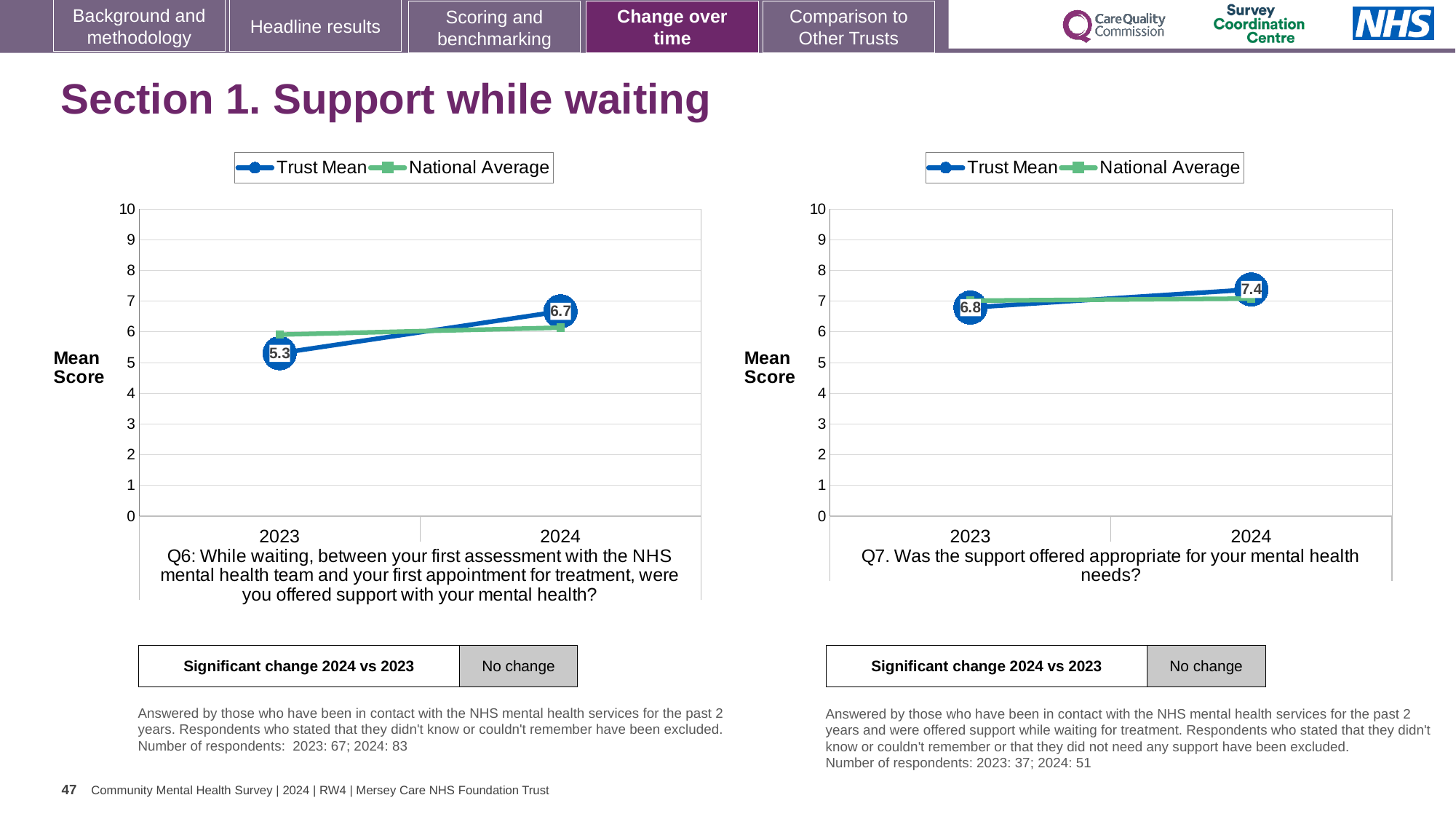
In the left chart (Q6), is the National Average for 2023 greater or less than 5? greater In the right chart (Q7), what is the Trust Mean for 2023? 6.8 In the right chart (Q7), what is the Trust Mean for 2024? 7.4 In the left chart (Q6), what is the Trust Mean for 2023? 5.3 In the left chart (Q6), what is the Trust Mean for 2024? 6.7 How many series does the legend of the left chart (Q6) list? 2 In the left chart (Q6), does the Trust Mean rise or fall from 2023 to 2024? rise In the left chart (Q6), by how much did the Trust Mean change from 2023 to 2024? 1.4 In the left chart (Q6), is the Trust Mean for 2024 larger or smaller than the National Average for 2024? larger In the right chart (Q7), which year has the higher Trust Mean, 2023 or 2024? 2024 What type of chart is the right chart (Q7)? line chart In the right chart (Q7), what is the difference between the Trust Mean in 2024 and in 2023? 0.6